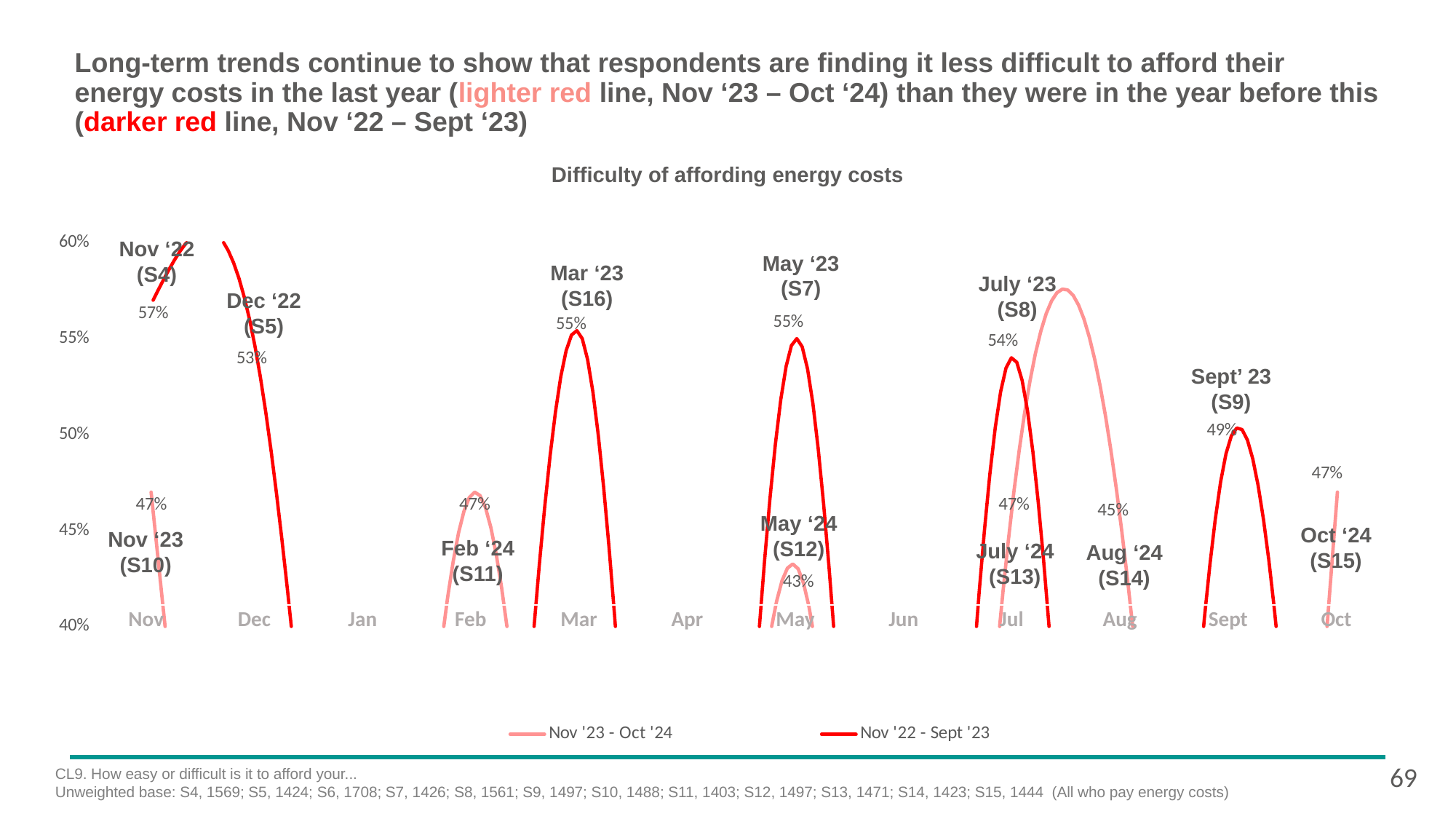
Which labelled point on the Nov '22 - Sept '23 line has the highest value? Nov '22 (S4) What is the value for Nov '22 (S4) on the Nov '22 - Sept '23 line? 57% What is the difference between the value for Nov '22 (S4) and the value for Nov '23 (S10)? 10% What is the title of the chart? Difficulty of affording energy costs What is the value for May '24 (S12) on the Nov '23 - Oct '24 line? 43% Which is larger, the value for July '23 (S8) or the value for July '24 (S13)? July '23 (S8) What type of chart is shown? line chart How many series does the legend list? 2 What is the value for Aug '24 (S14)? 45% What is the value for Sept '23 (S9)? 49% Is the value for Dec '22 (S5) greater or less than 50%? greater Which labelled point on the Nov '23 - Oct '24 line has the lowest value? May '24 (S12)